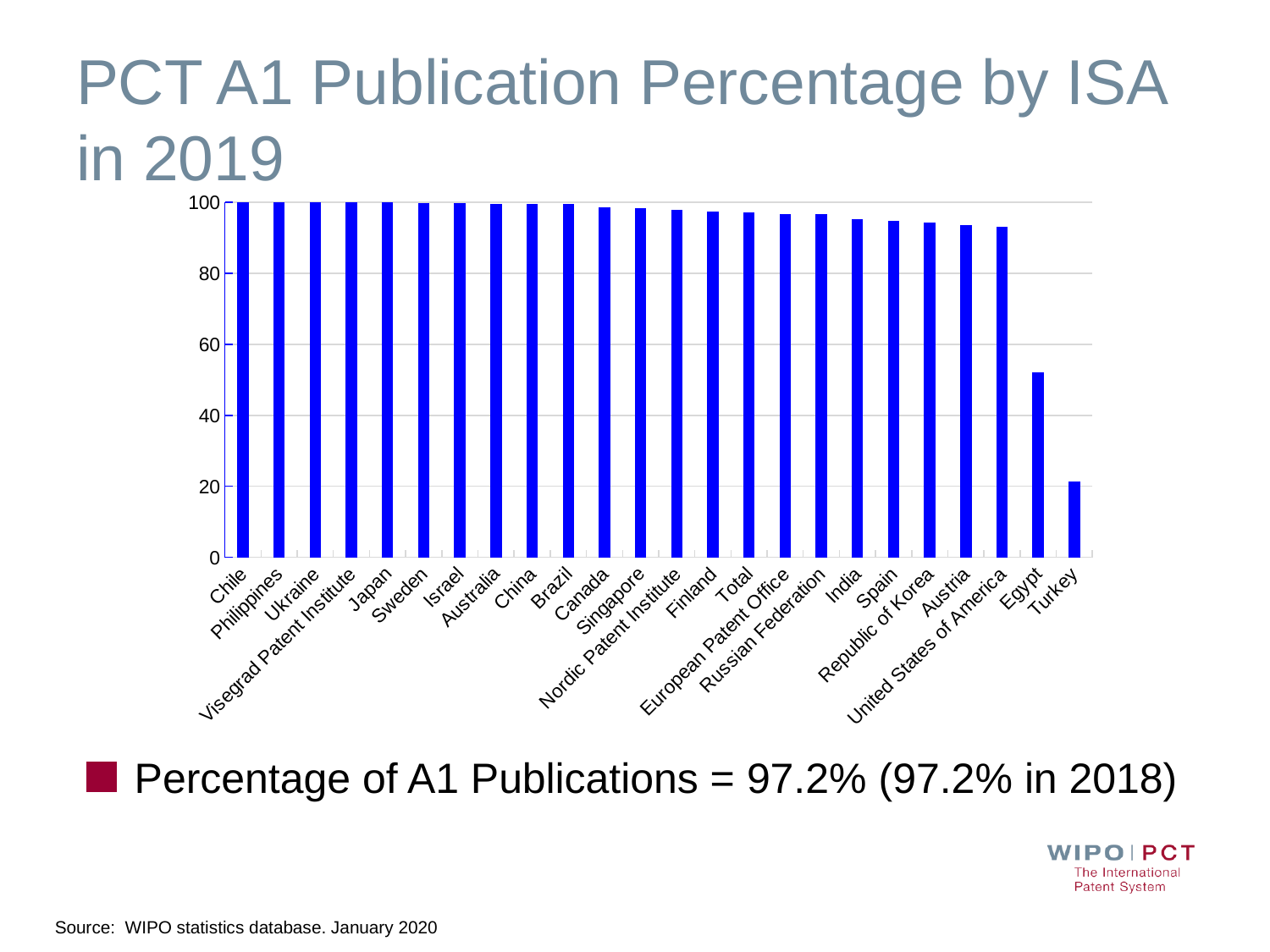
Is the value for Chile greater or less than 80? greater What kind of chart is shown on the slide? bar chart Which has the larger value, Egypt or Turkey? Egypt According to the text below the chart, what is the overall percentage of A1 publications in 2019? 97.2% Which category has the lowest value in the chart? Turkey Is the value for Egypt greater or less than 60? less How many categories (ISAs) are plotted on the x axis of the chart? 24 Is the value for Turkey greater or less than 40? less Do the values rise or fall moving from left to right along the x axis? fall What is the title of the chart on the slide? PCT A1 Publication Percentage by ISA in 2019 Which has the larger value, United States of America or Egypt? United States of America